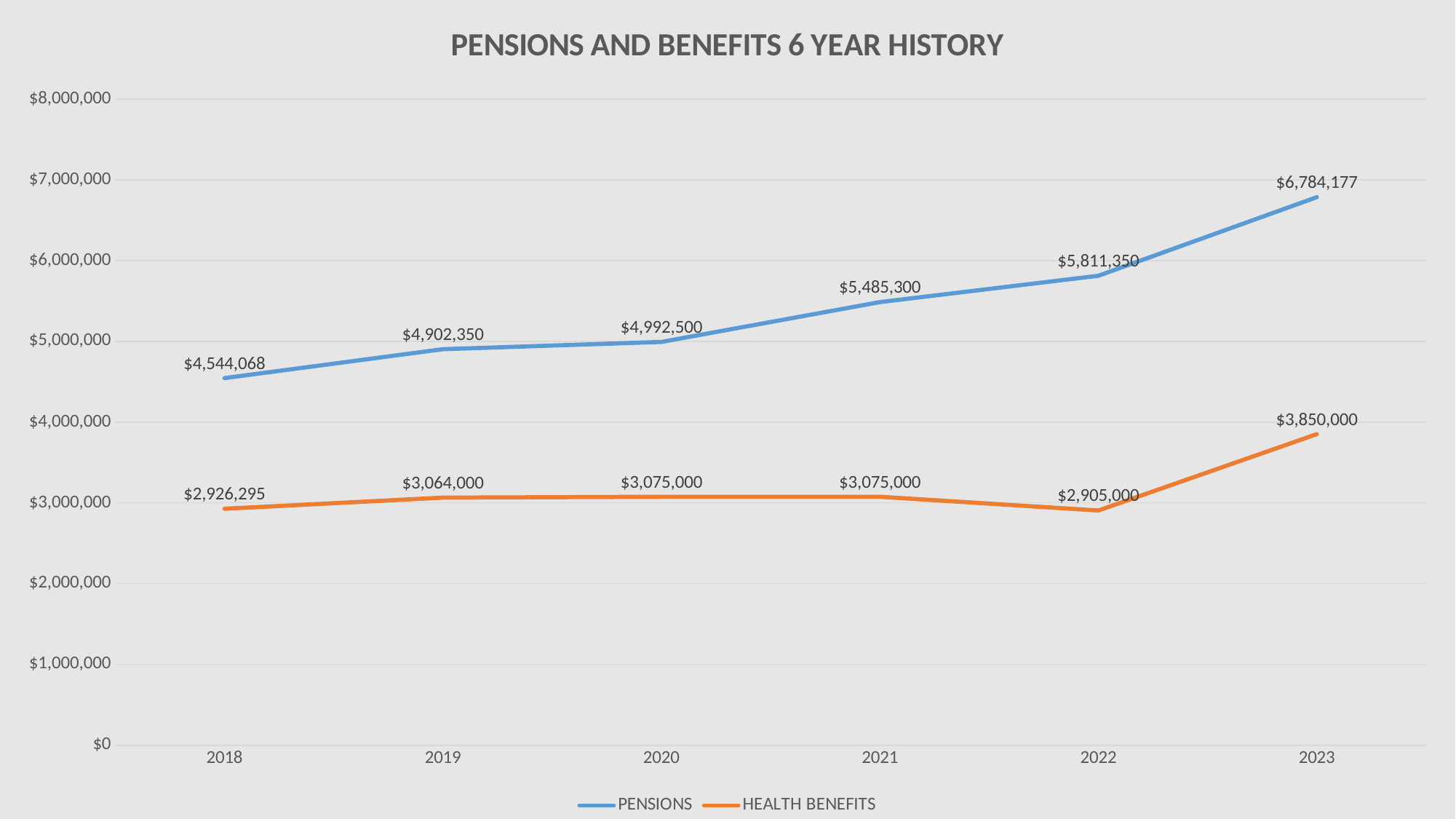
What type of chart is shown on the slide? Line chart How many series does the legend list? 2 Which is larger, HEALTH BENEFITS in 2020 or HEALTH BENEFITS in 2022? HEALTH BENEFITS in 2020 Do the PENSIONS values rise or fall from 2018 to 2023? Rise In which year is the HEALTH BENEFITS value lowest? 2022 What is the value for PENSIONS in 2021? $5,485,300 What is the title of the chart? PENSIONS AND BENEFITS 6 YEAR HISTORY In which year is the PENSIONS value highest? 2023 By how much did PENSIONS increase from 2018 to 2023? $2,240,109 What is the value for HEALTH BENEFITS in 2019? $3,064,000 What is the difference between PENSIONS and HEALTH BENEFITS in 2023? $2,934,177 How many years are plotted on the x axis? 6